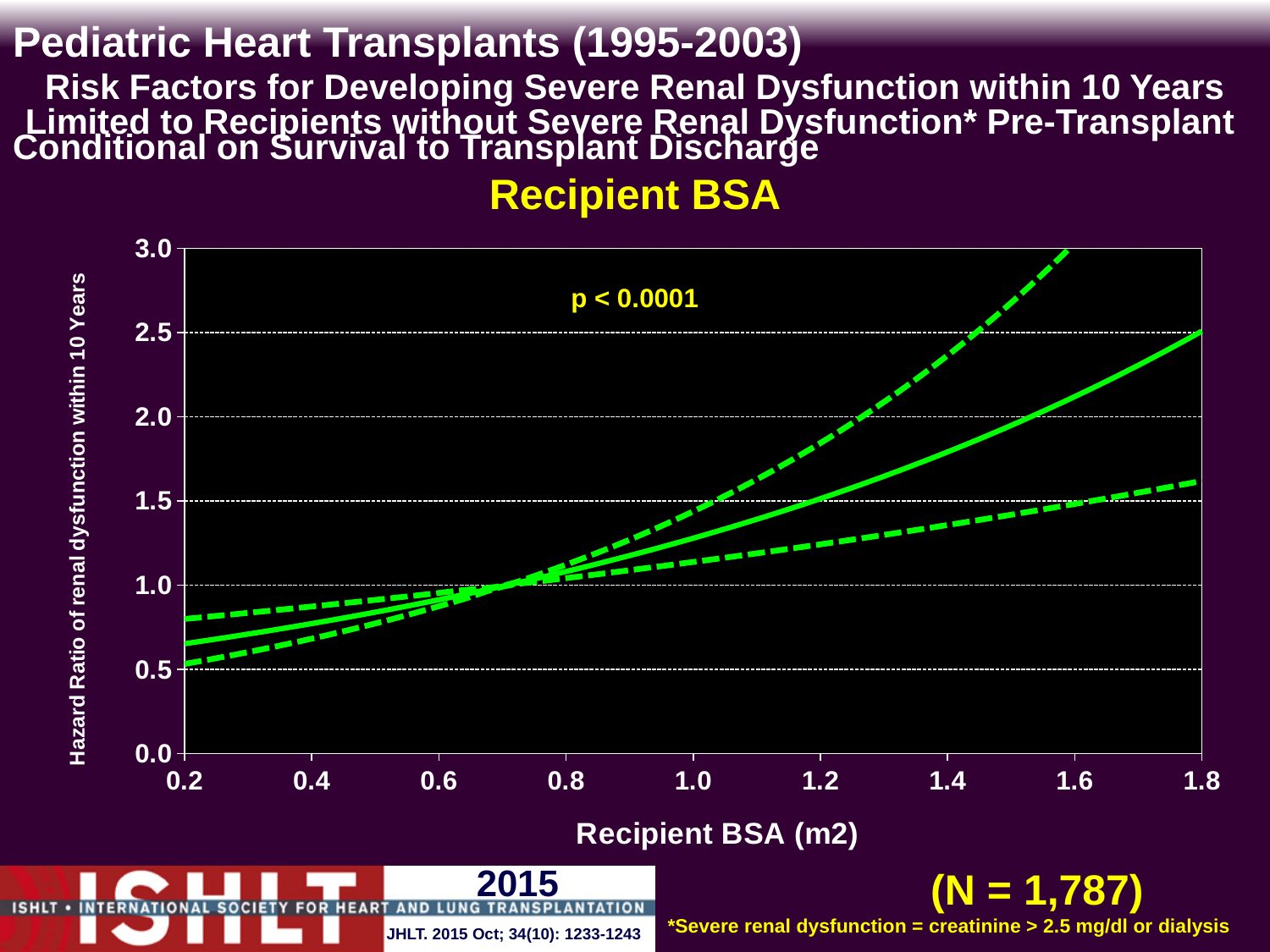
How many lines are plotted on the chart? 3 What kind of chart is shown on the slide? line chart Which is larger at a Recipient BSA of 1.6: the upper dashed line or the lower dashed line? the upper dashed line Is the hazard ratio on the solid line at a Recipient BSA of 1.8 greater or less than 2.0? greater Does the solid hazard ratio line rise or fall as Recipient BSA increases from 0.2 to 1.8? rise Is the hazard ratio on the solid line at a Recipient BSA of 0.2 greater or less than 1.0? less Is the upper dashed line at a Recipient BSA of 1.4 greater or less than 2.0? greater What is the label of the x axis? Recipient BSA (m2) What p-value is printed on the chart? p < 0.0001